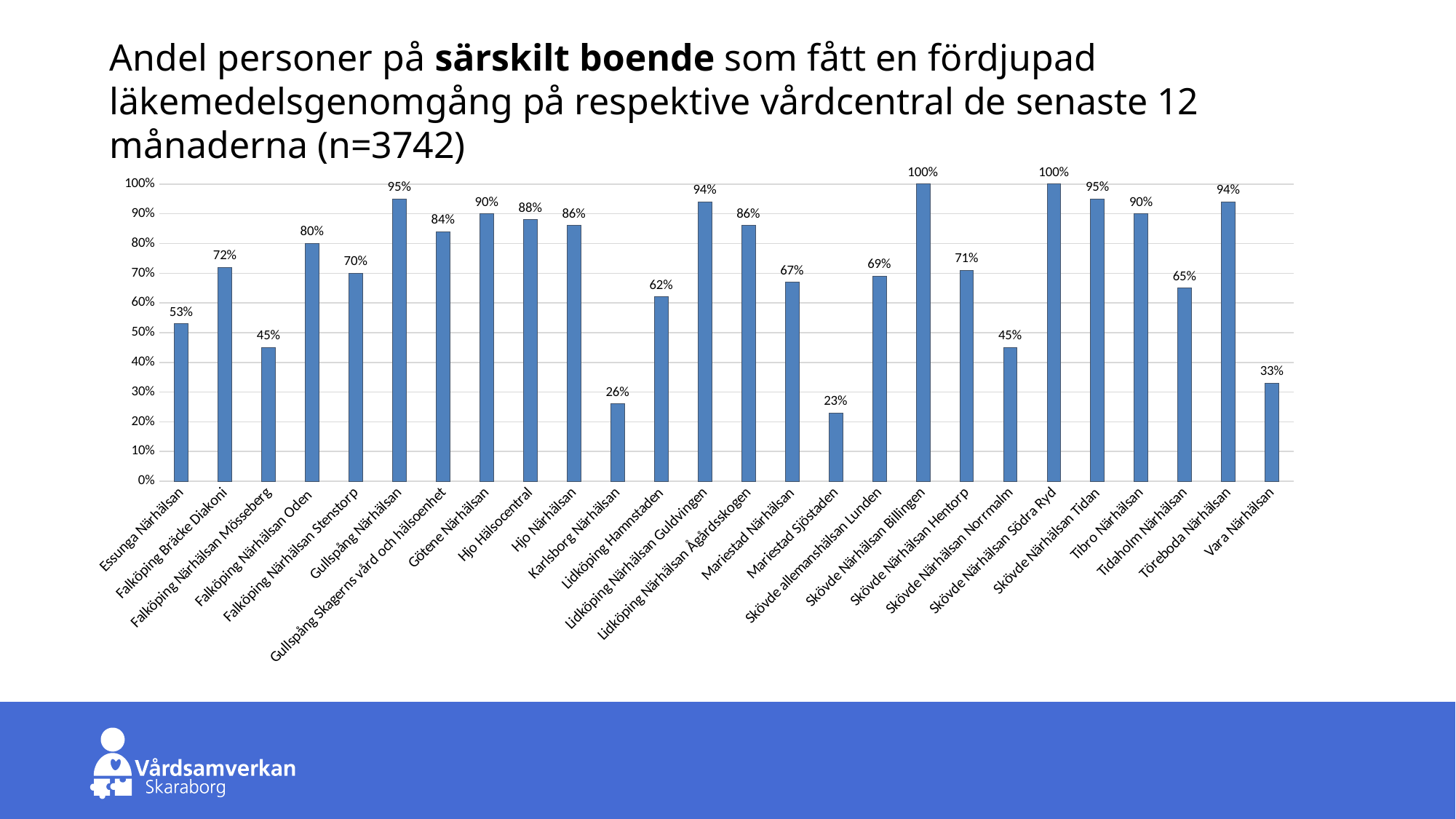
What is the value for Karlsborg Närhälsan? 26% What is the difference between the values for Gullspång Närhälsan and Vara Närhälsan? 62% What is the value for Töreboda Närhälsan? 94% What is the value for Essunga Närhälsan? 53% How many vårdcentraler are shown on the x axis? 26 What kind of chart is shown on the slide? Bar chart What is the value for Skövde Närhälsan Hentorp? 71% What is the sample size (n) stated in the chart title? 3742 What is the difference between the values for Hjo Hälsocentral and Lidköping Hamnstaden? 26% Which is larger, the value for Falköping Bräcke Diakoni or the value for Tidaholm Närhälsan? Falköping Bräcke Diakoni Which is larger, the value for Mariestad Närhälsan or the value for Skövde Närhälsan Norrmalm? Mariestad Närhälsan Which vårdcentral has the lowest value? Mariestad Sjöstaden